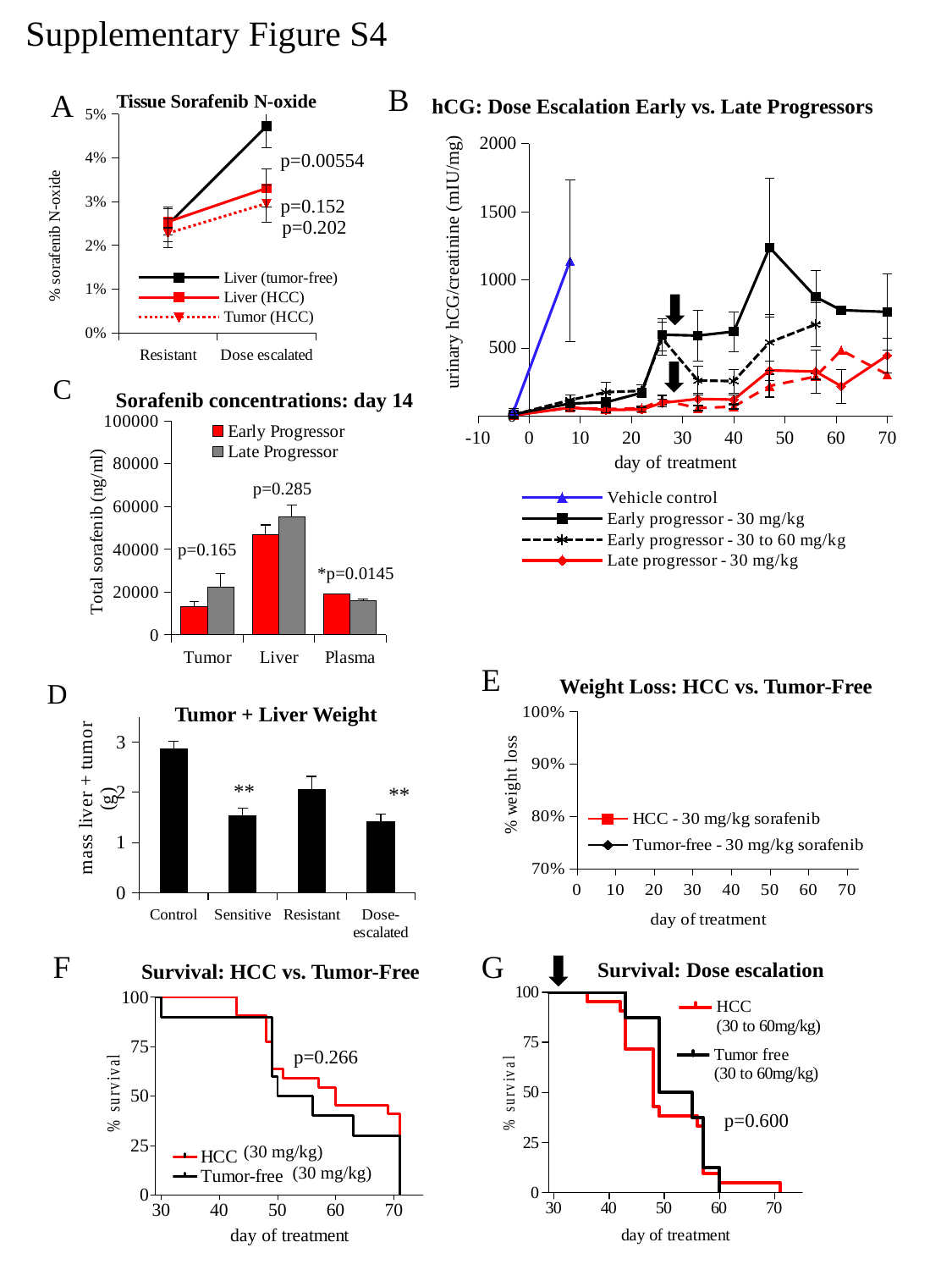
In the 'Tumor + Liver Weight' chart (panel D), is the value for Control greater or less than 2? greater In the 'Tumor + Liver Weight' chart (panel D), which category has the highest bar? Control In the 'Sorafenib concentrations: day 14' chart (panel C), what p-value is printed above the Plasma bars? *p=0.0145 In the 'hCG: Dose Escalation Early vs. Late Progressors' chart (panel B), how many series does the legend list? 4 In the 'Tissue Sorafenib N-oxide' chart (panel A), how many series does the legend list? 3 In the 'Sorafenib concentrations: day 14' chart (panel C), is the Late Progressor value for Liver greater or less than 40000? greater In the 'Sorafenib concentrations: day 14' chart (panel C), which category has the highest Late Progressor bar? Liver In the 'Tumor + Liver Weight' chart (panel D), which is larger, the value for Sensitive or the value for Resistant? Resistant In the 'Sorafenib concentrations: day 14' chart (panel C), how many categories are shown on the x axis? 3 In the 'hCG: Dose Escalation Early vs. Late Progressors' chart (panel B), is the Early progressor - 30 mg/kg value at day 47 greater or less than 1000? greater In the 'Tissue Sorafenib N-oxide' chart (panel A), does the Liver (tumor-free) series rise or fall from Resistant to Dose escalated? rise What kind of chart is the 'Tissue Sorafenib N-oxide' chart (panel A)? line chart